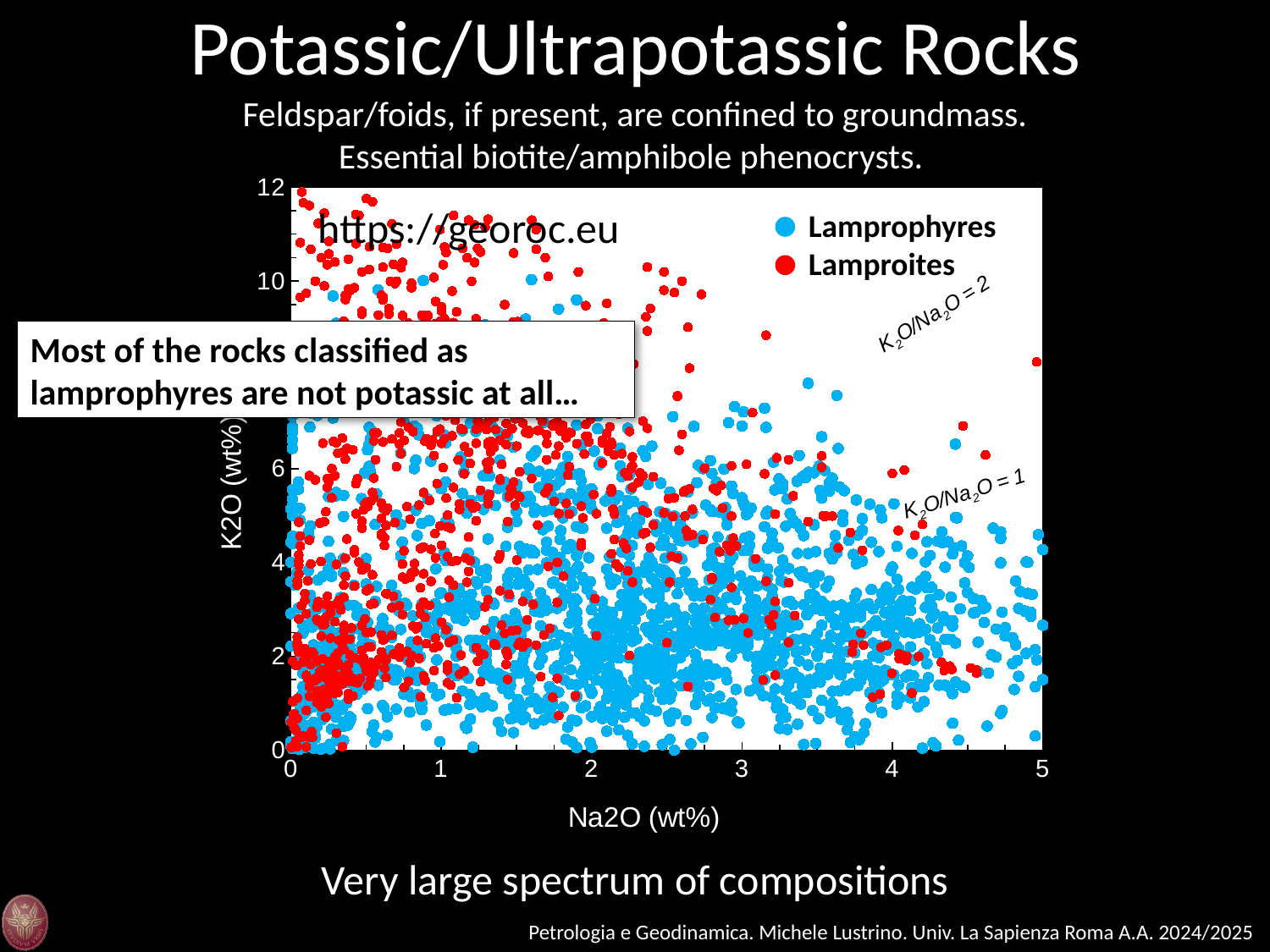
How many series does the legend list? 2 Which series has more points with K2O above 8 wt%, Lamprophyres or Lamproites? Lamproites Which series has more points with Na2O above 4 wt%, Lamprophyres or Lamproites? Lamprophyres Which series is plotted with red markers? Lamproites Which series has more points with K2O below 2 wt% at Na2O above 3 wt%, Lamprophyres or Lamproites? Lamprophyres What are the two series named in the legend? Lamprophyres and Lamproites What kind of chart is shown on the slide? scatter plot Which series contains the points with the highest K2O values on the chart? Lamproites